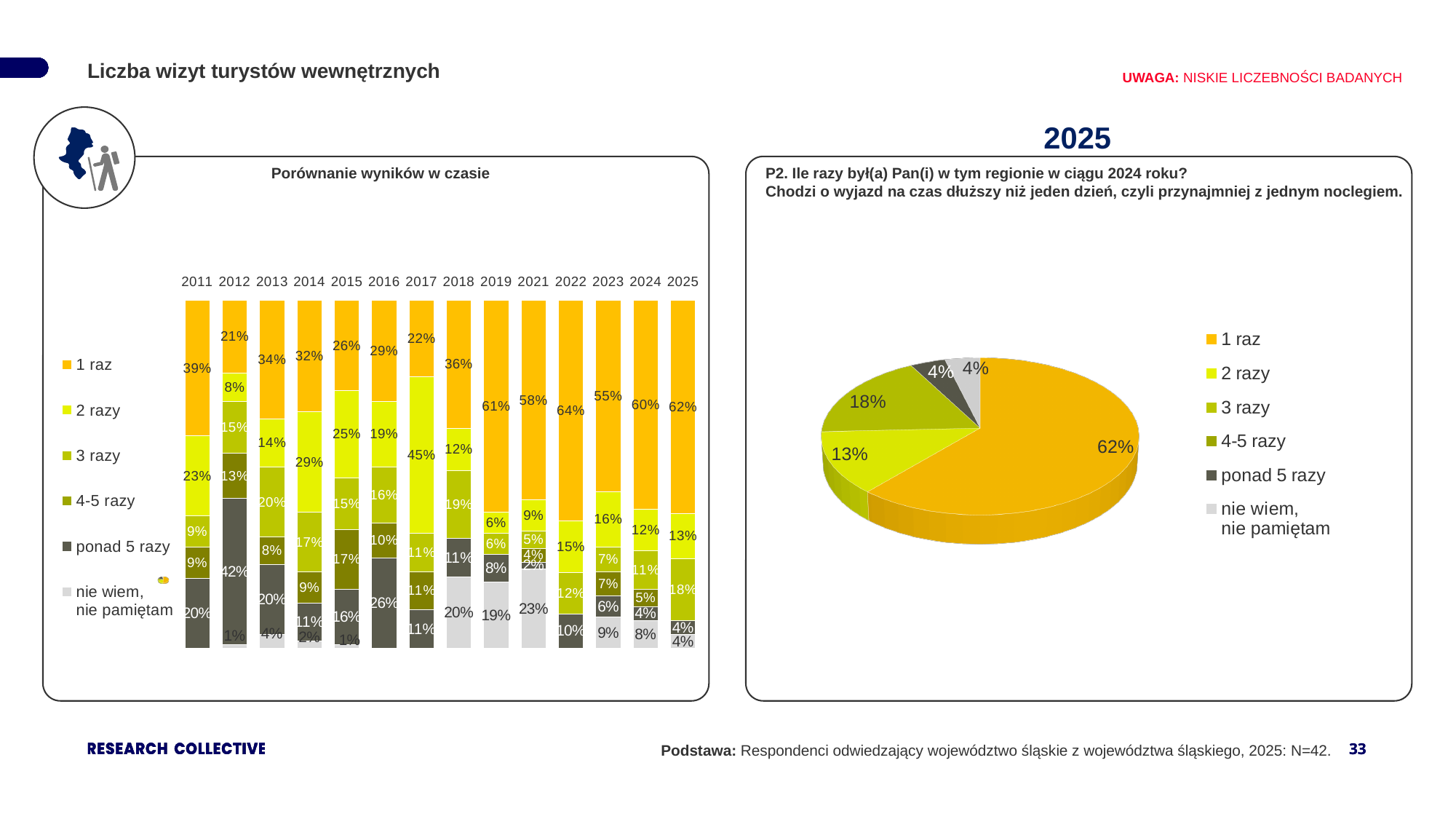
In the chart 'Porównanie wyników w czasie', which year has the larger '2 razy' value, 2017 or 2018? 2017 In the chart 'Porównanie wyników w czasie', what is the value for 'nie wiem, nie pamiętam' in 2021? 23% In the chart 'Porównanie wyników w czasie', what is the value for 'ponad 5 razy' in 2012? 42% How many years (bars) are shown in the chart 'Porównanie wyników w czasie'? 14 In the pie chart on the right (2025), what share of respondents answered '1 raz'? 62% In the pie chart on the right (2025), which category has the largest slice? 1 raz In the chart 'Porównanie wyników w czasie', what is the value for '1 raz' in 2011? 39% How many entries does the legend of the pie chart on the right list? 6 What kind of chart is shown on the right side of the slide under '2025'? Pie chart In the chart 'Porównanie wyników w czasie', what is the value for '1 raz' in 2019? 61% In the chart 'Porównanie wyników w czasie', by how many percentage points does the '1 raz' value in 2025 exceed that in 2024? 2 percentage points In the pie chart on the right (2025), what is the value for '3 razy'? 18%